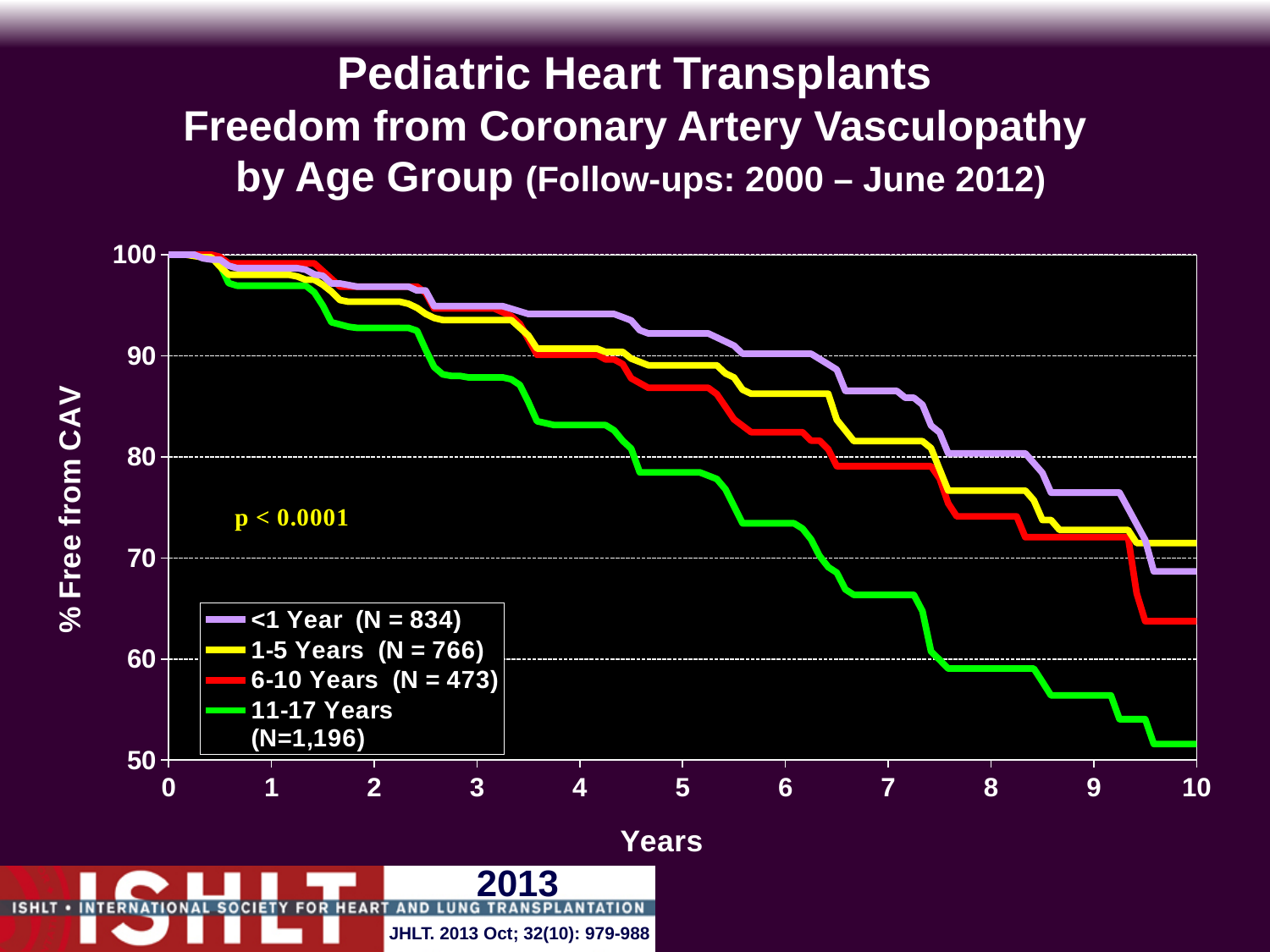
What kind of chart is shown on the slide? line chart Which age group has the highest freedom from CAV at 5 years? <1 Year At 10 years, which is larger: the value for 6-10 Years or the value for 11-17 Years? 6-10 Years Which age group has the lowest freedom from CAV at 10 years? 11-17 Years How many series does the legend list? 4 What is the N for the 11-17 Years group shown in the legend? 1,196 What p-value is printed on the chart? p < 0.0001 Is the value for 11-17 Years at 10 years greater or less than 60? less Is the value for 6-10 Years at 10 years greater or less than 60? greater Do the values for each age group rise or fall as years increase? fall Is the value for <1 Year at 5 years greater or less than 90? greater